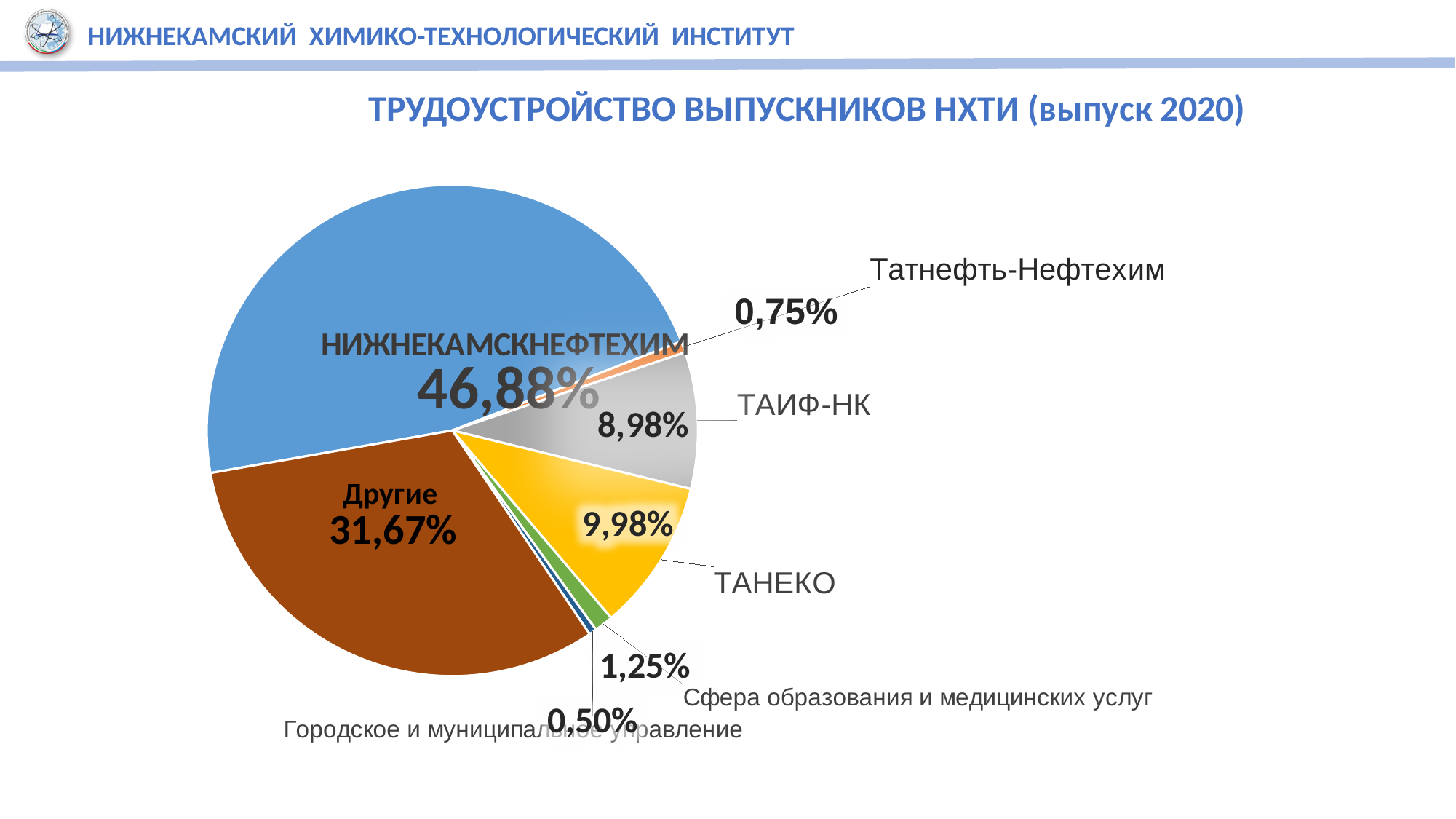
What is the title of the chart on the slide? ТРУДОУСТРОЙСТВО ВЫПУСКНИКОВ НХТИ (выпуск 2020) What is the value for Сфера образования и медицинских услуг? 1,25% What is the value for Татнефть-Нефтехим? 0,75% What share of graduates was employed at НИЖНЕКАМСКНЕФТЕХИМ? 46,88% What percentage is shown for ТАНЕКО? 9,98% Which is larger, the share for ТАНЕКО or the share for ТАИФ-НК? ТАНЕКО What type of chart is shown on the slide? pie chart Which category has the smallest share of the pie? Городское и муниципальное управление Which category has the largest share of the pie? НИЖНЕКАМСКНЕФТЕХИМ What is the value shown for the Другие slice? 31,67% How many slices does the pie chart have? 7 What percentage is shown for ТАИФ-НК? 8,98%